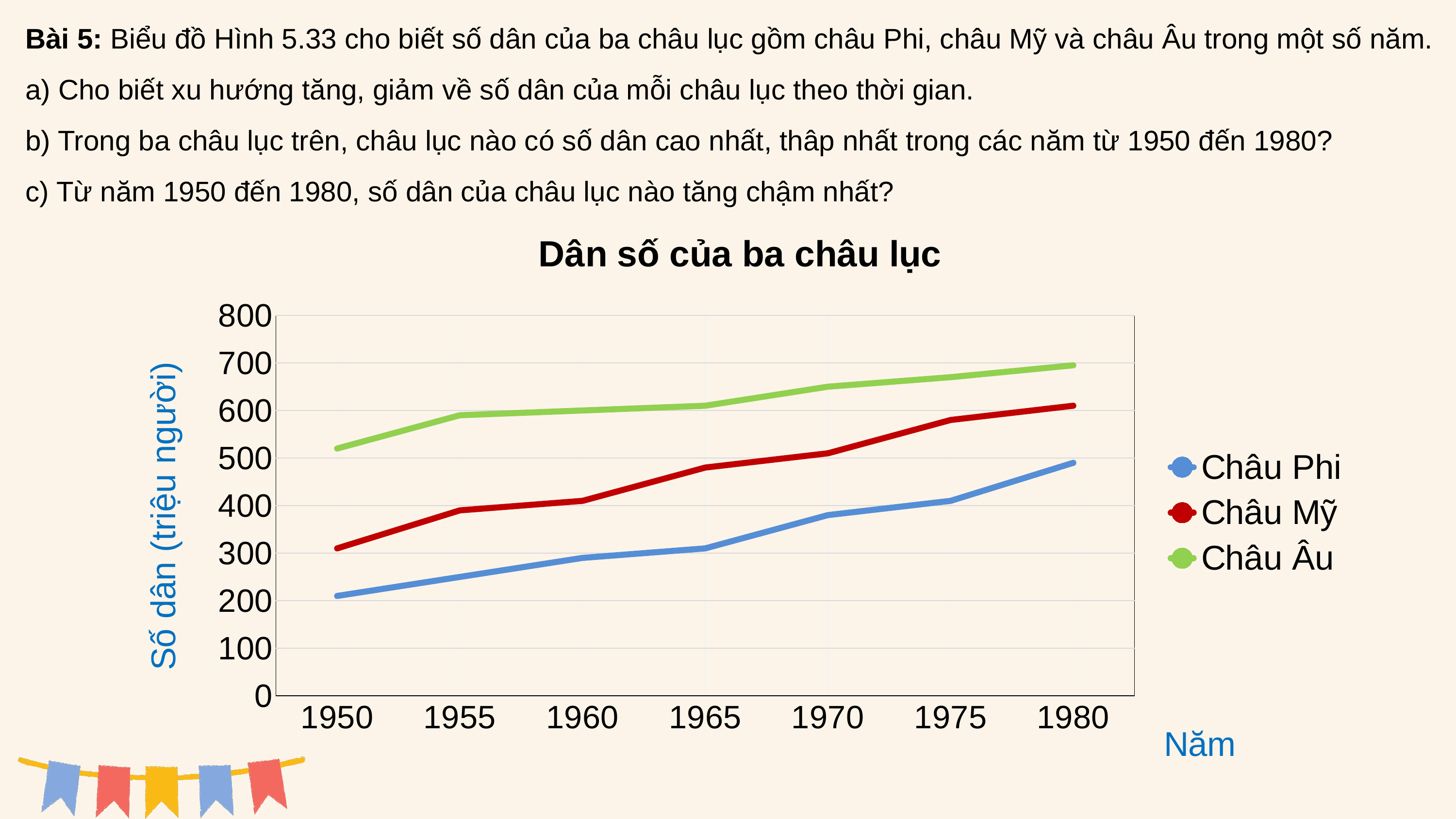
Is the value for Châu Phi in 1950 greater or less than 300? less Is the value for Châu Âu in 1980 greater or less than 600? greater How many years are plotted along the x axis? 7 Does the population of Châu Phi rise or fall from 1950 to 1980? rise How many series does the legend list? 3 What is the label of the vertical axis? Số dân (triệu người) In 1960, which is larger: the population of Châu Mỹ or Châu Phi? Châu Mỹ What is the title of the chart? Dân số của ba châu lục Is the value for Châu Mỹ in 1980 greater or less than 500? greater What kind of chart is shown on the slide? line chart Which continent has the highest population in 1980? Châu Âu Which continent has the lowest population in 1950? Châu Phi